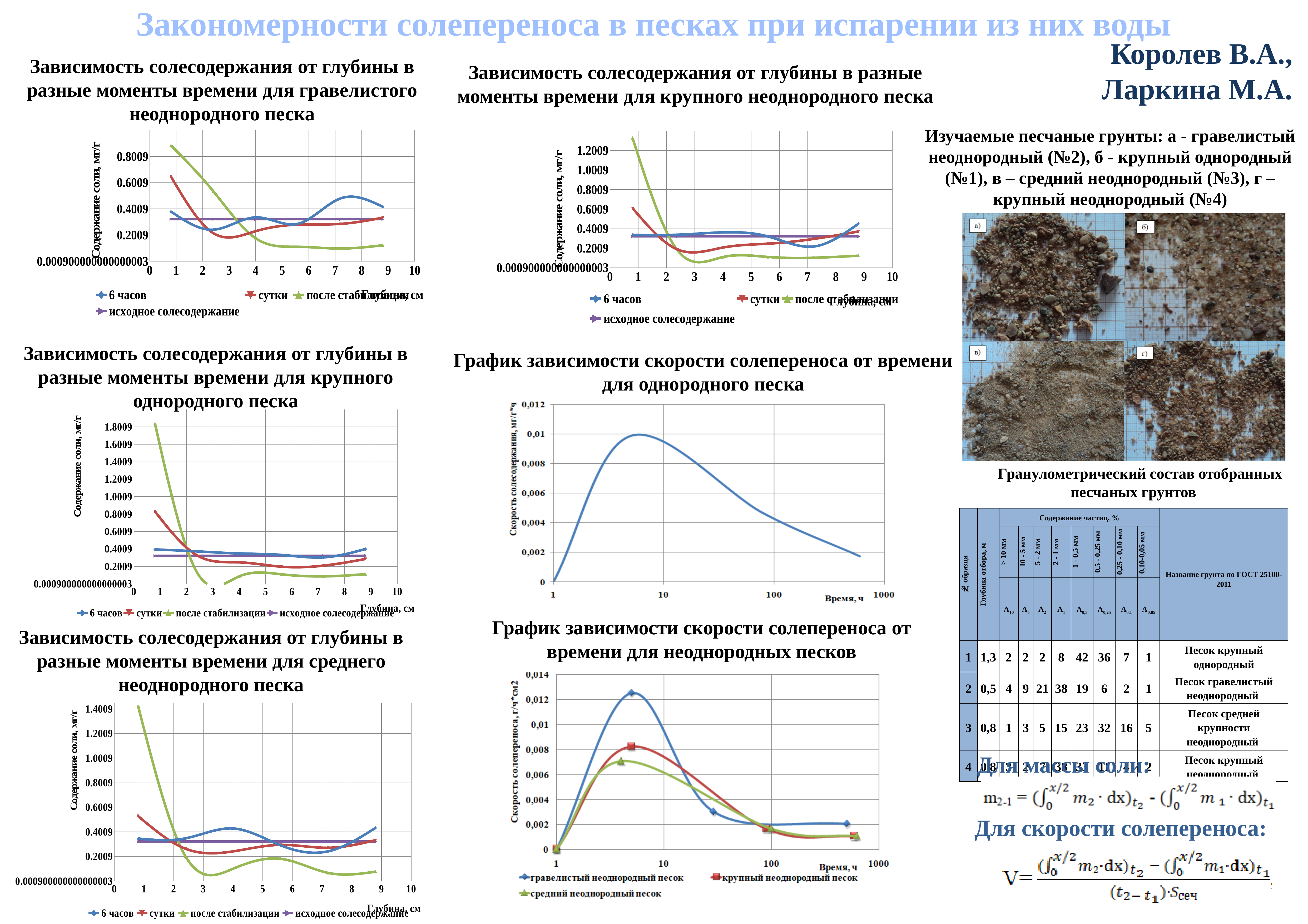
In the chart 'График зависимости скорости солепереноса от времени для однородного песка', does the curve rise or fall as time increases from 10 to 1000 hours? fall In the top-middle chart for крупного неоднородного песка, is the value of 'после стабилизации' at depth 1 cm greater or less than 1.2009? greater In the bottom-left chart for среднего неоднородного песка, is the value of 'после стабилизации' at depth 1 cm greater or less than 1.2009? greater In the chart 'График зависимости скорости солепереноса от времени для неоднородных песков', is the peak value of 'гравелистый неоднородный песок' greater or less than 0.01? greater What is the x-axis label of the chart 'График зависимости скорости солепереноса от времени для неоднородных песков'? Время, ч How many series does the legend list in the top-left chart for гравелистого неоднородного песка? 4 How many series does the legend list in the chart 'График зависимости скорости солепереноса от времени для неоднородных песков'? 3 In the chart 'График зависимости скорости солепереноса от времени для неоднородных песков', which series reaches the highest peak? гравелистый неоднородный песок What kind of chart is the top-left chart titled 'Зависимость солесодержания от глубины в разные моменты времени для гравелистого неоднородного песка'? line chart